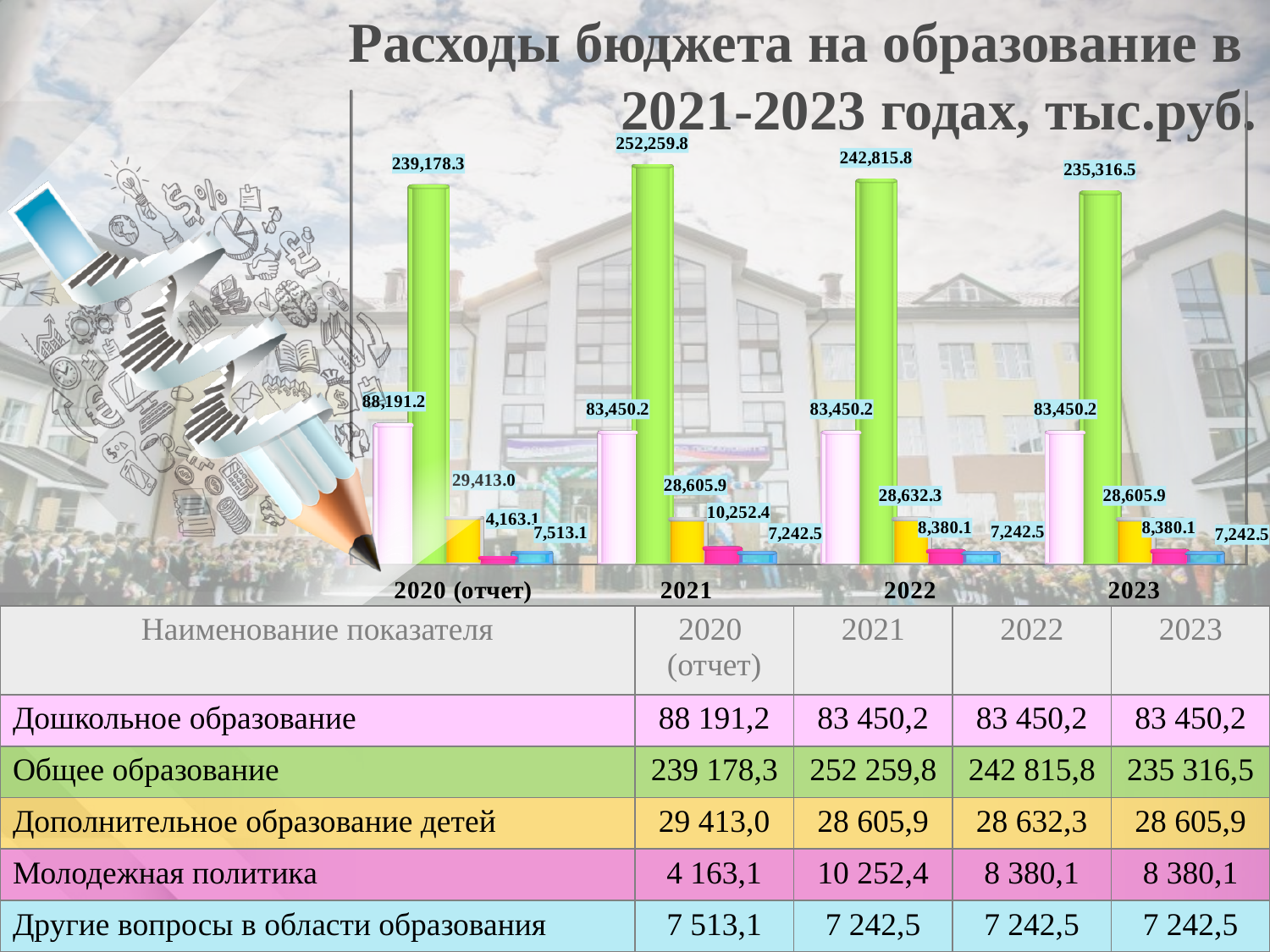
What kind of chart is shown on the slide? bar chart What is the value of the tallest (green) bar for 2021? 252,259.8 What is the value of the blue bar (Другие вопросы в области образования) for 2023? 7,242.5 How many year categories are shown on the x axis? 4 Does the green bar (Общее образование) rise or fall from 2021 to 2023? fall Which is larger: the green bar for 2022 or the green bar for 2023? 2022 What is the value of the yellow bar (Дополнительное образование детей) for 2022? 28,632.3 What is the value of the magenta bar (Молодежная политика) for 2021? 10,252.4 In which year is the green bar (Общее образование) highest? 2021 What is the difference between the green bar values for 2021 and 2020 (отчет)? 13,081.5 In which year is the magenta bar (Молодежная политика) lowest? 2020 (отчет) What is the value of the pink bar (Дошкольное образование) for 2020 (отчет)? 88,191.2